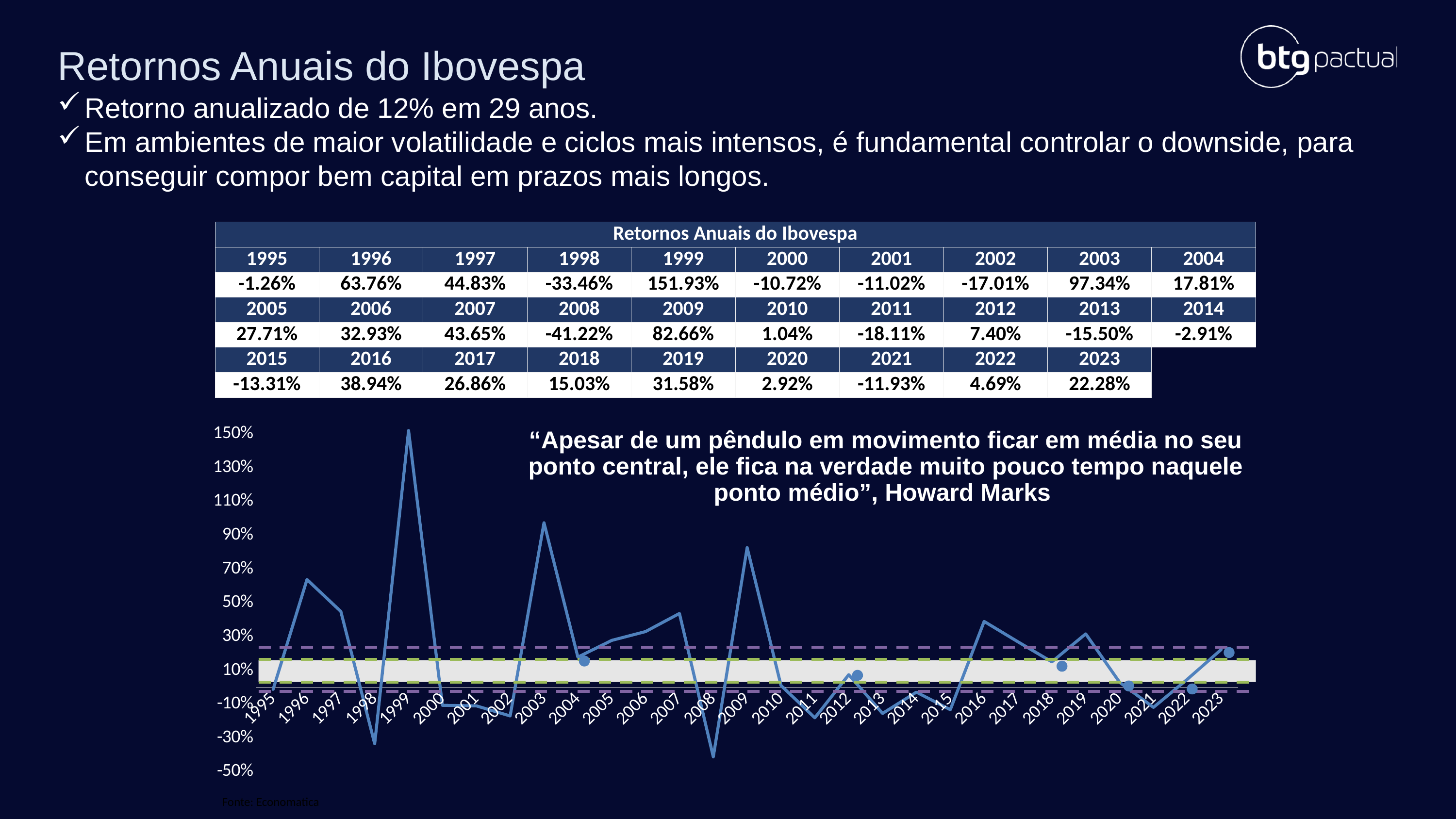
What is the difference between the 2016 return and the 2017 return? 12.08% From 2016 to 2018, do the annual returns rise or fall? fall Is the value for 2009 greater or less than 70%? greater What was the Ibovespa annual return in 2003? 97.34% What was the Ibovespa annual return in 2008? -41.22% Which year has the highest annual return of the Ibovespa? 1999 What was the Ibovespa annual return in 2023? 22.28% What kind of chart is shown at the bottom of the slide? line chart How many years are plotted on the x axis of the line chart? 29 Which year has the lowest annual return of the Ibovespa? 2008 What is the source cited below the chart? Economatica Which year had the larger return, 1996 or 1997? 1996